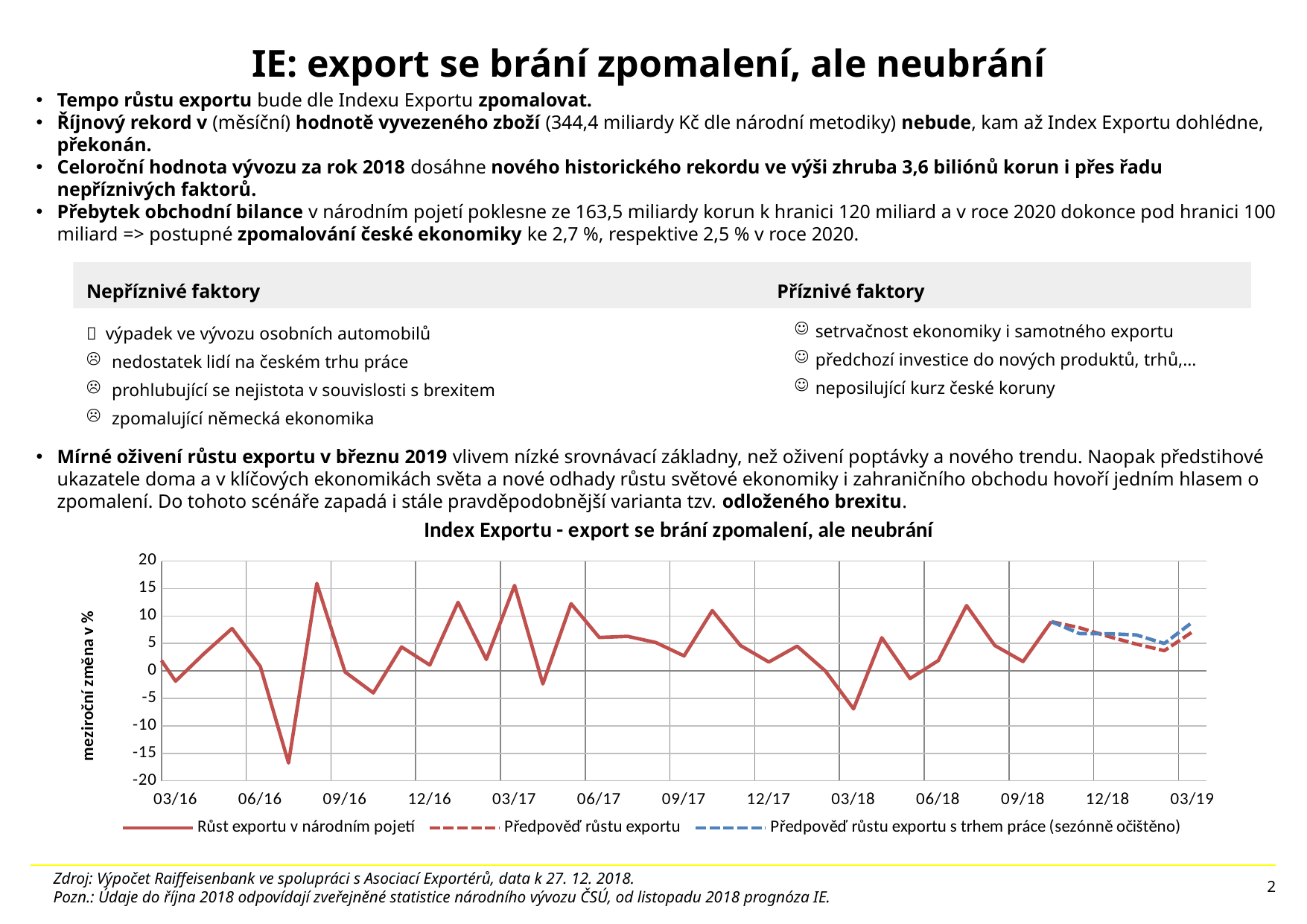
Is the value of 'Růst exportu v národním pojetí' at 03/18 greater or less than -5? less What kind of chart is shown on the slide? line chart Is the value of 'Růst exportu v národním pojetí' at 03/17 greater or less than 10? greater How many date labels are shown on the horizontal axis of the chart? 13 What is the title of the chart? Index Exportu - export se brání zpomalení, ale neubrání Which is higher for 'Růst exportu v národním pojetí': the value at 03/17 or the value at 03/18? 03/17 What is the label of the vertical axis of the chart? meziroční změna v % Is the lowest value of the 'Růst exportu v národním pojetí' line greater or less than -15? less At 03/19, which forecast line is higher: 'Předpověď růstu exportu' or 'Předpověď růstu exportu s trhem práce (sezónně očištěno)'? Předpověď růstu exportu s trhem práce (sezónně očištěno) How many series does the chart legend list? 3